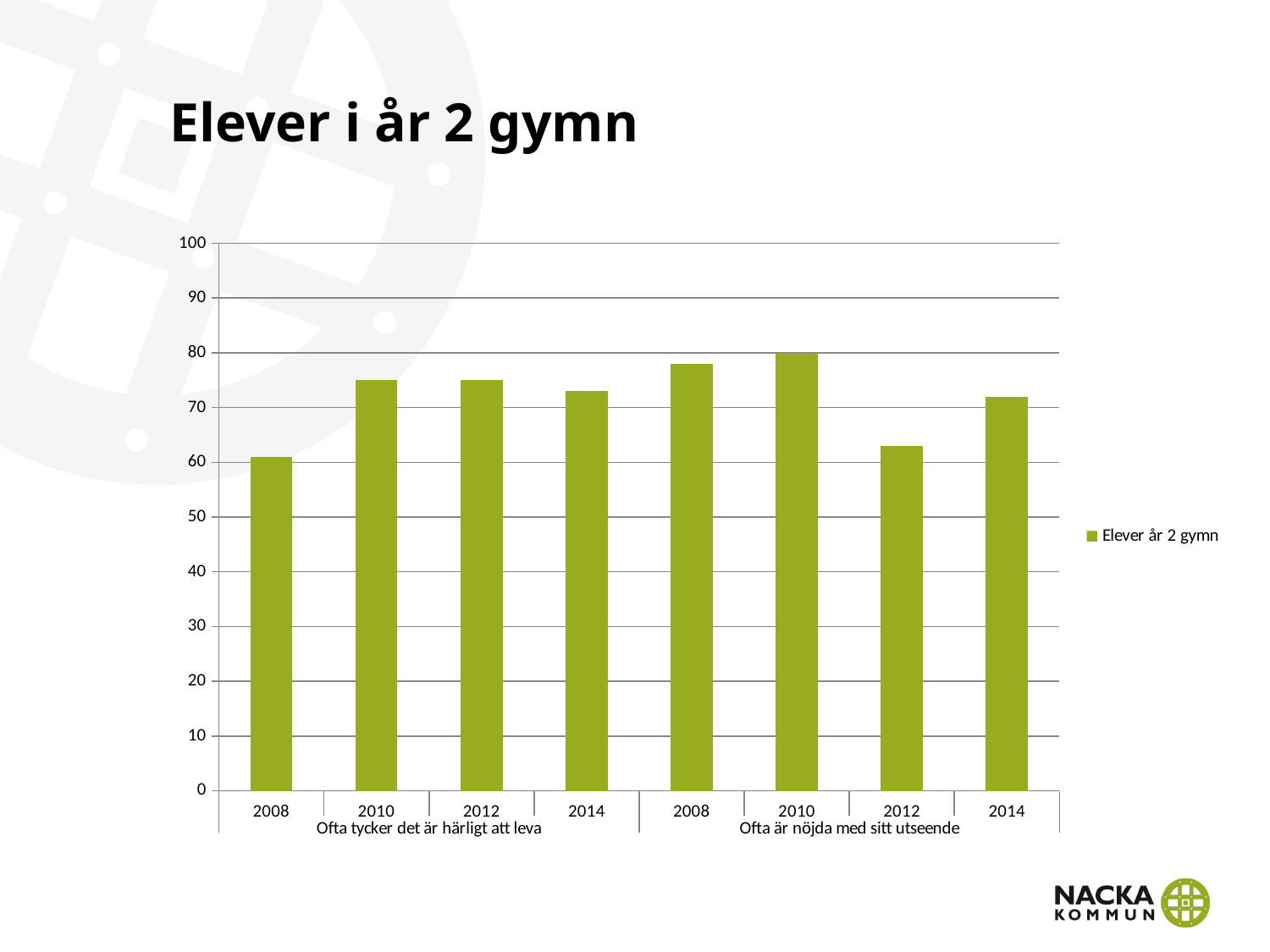
How many series does the legend list? 1 What is the legend entry for the series? Elever år 2 gymn Which is larger in 'Ofta är nöjda med sitt utseende': the value for 2010 or the value for 2012? 2010 What kind of chart is shown on the slide? bar chart Which is larger: the 2008 value for 'Ofta tycker det är härligt att leva' or the 2008 value for 'Ofta är nöjda med sitt utseende'? Ofta är nöjda med sitt utseende Within the group 'Ofta är nöjda med sitt utseende', which year has the lowest bar? 2012 Is the value for 2010 in 'Ofta tycker det är härligt att leva' greater or less than 70? greater Is the value for 2012 in 'Ofta är nöjda med sitt utseende' greater or less than 70? less Is the value for 2008 in 'Ofta tycker det är härligt att leva' greater or less than 70? less How many bars are plotted in the chart? 8 What is the title of the slide? Elever i år 2 gymn Within the group 'Ofta tycker det är härligt att leva', which year has the lowest bar? 2008